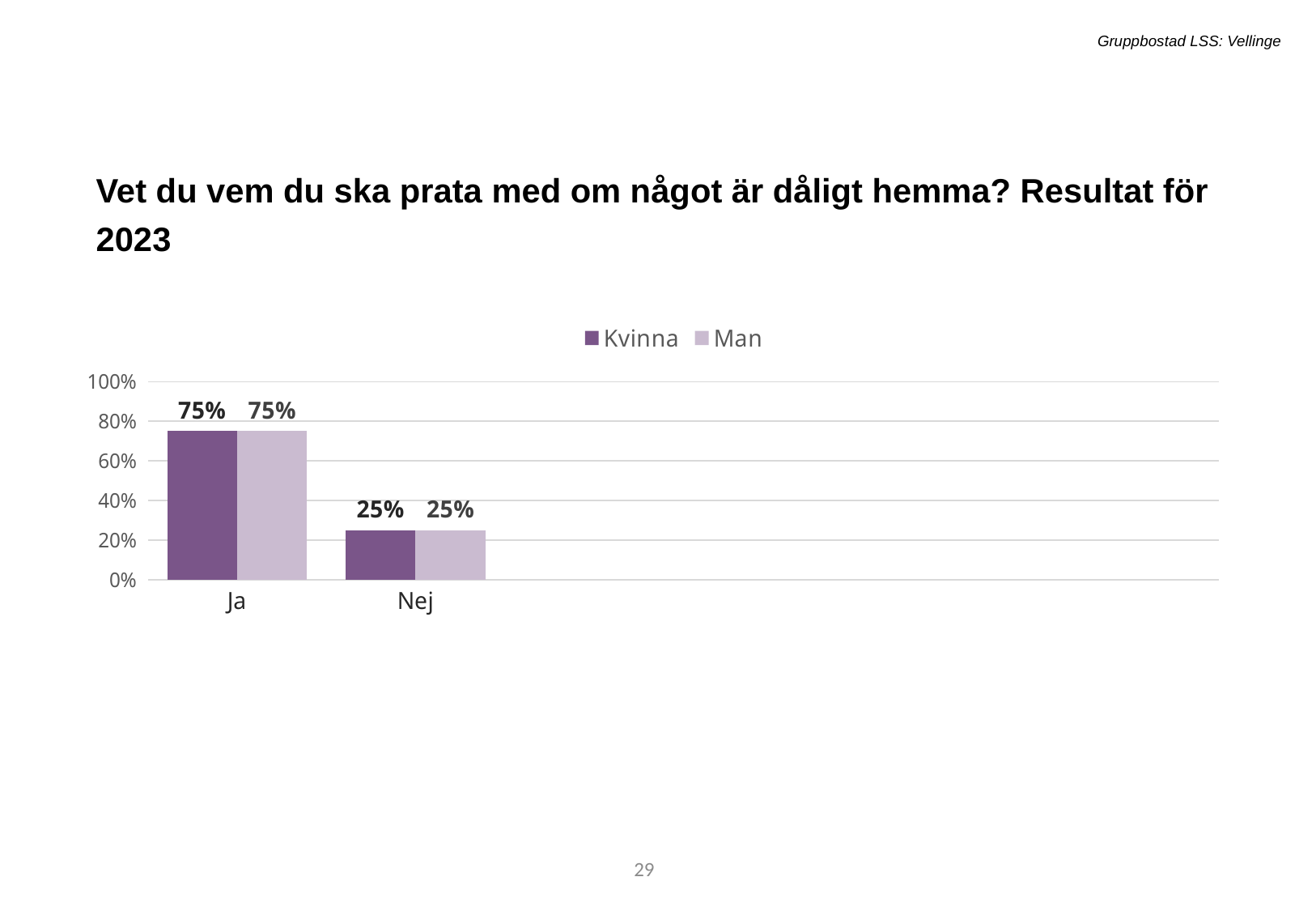
What kind of chart is shown on the slide? Bar chart What is the difference between the Kvinna values for Ja and Nej? 50% What is the value for Kvinna in the Ja category? 75% What is the value for Man in the Ja category? 75% What is the value for Kvinna in the Nej category? 25% How many series does the legend list? 2 Which category has the lowest value for Man? Nej What are the two series names listed in the legend? Kvinna and Man What is the value for Man in the Nej category? 25% Which category has the highest value for Kvinna? Ja Which is larger for Man: the value for Ja or the value for Nej? Ja How many categories are shown on the x axis? 2